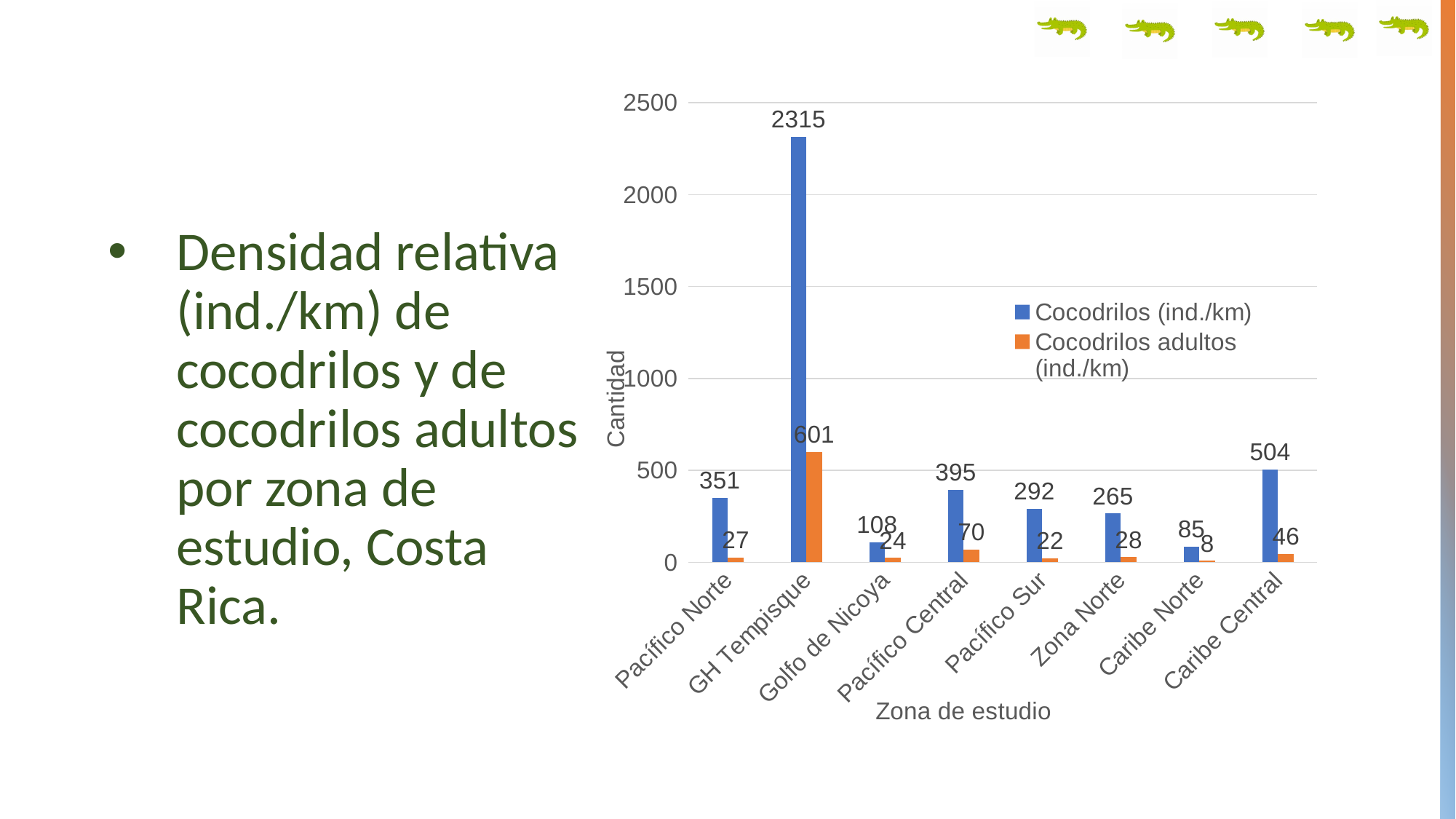
Is the value for Cocodrilos (ind./km) in Caribe Central greater or less than 500? greater What is the value for Cocodrilos (ind./km) in GH Tempisque? 2315 Which is larger, the Cocodrilos (ind./km) value for Pacífico Norte or for Pacífico Central? Pacífico Central What is the value for Cocodrilos (ind./km) in Caribe Central? 504 What is the difference between the Cocodrilos (ind./km) value and the Cocodrilos adultos (ind./km) value in GH Tempisque? 1714 How many study zones are shown on the x axis? 8 Which zone has the highest value for Cocodrilos (ind./km)? GH Tempisque What is the label of the x axis? Zona de estudio How many series does the legend list? 2 What is the value for Cocodrilos adultos (ind./km) in Pacífico Central? 70 What kind of chart is shown on the slide? Bar chart Which zone has the lowest value for Cocodrilos adultos (ind./km)? Caribe Norte